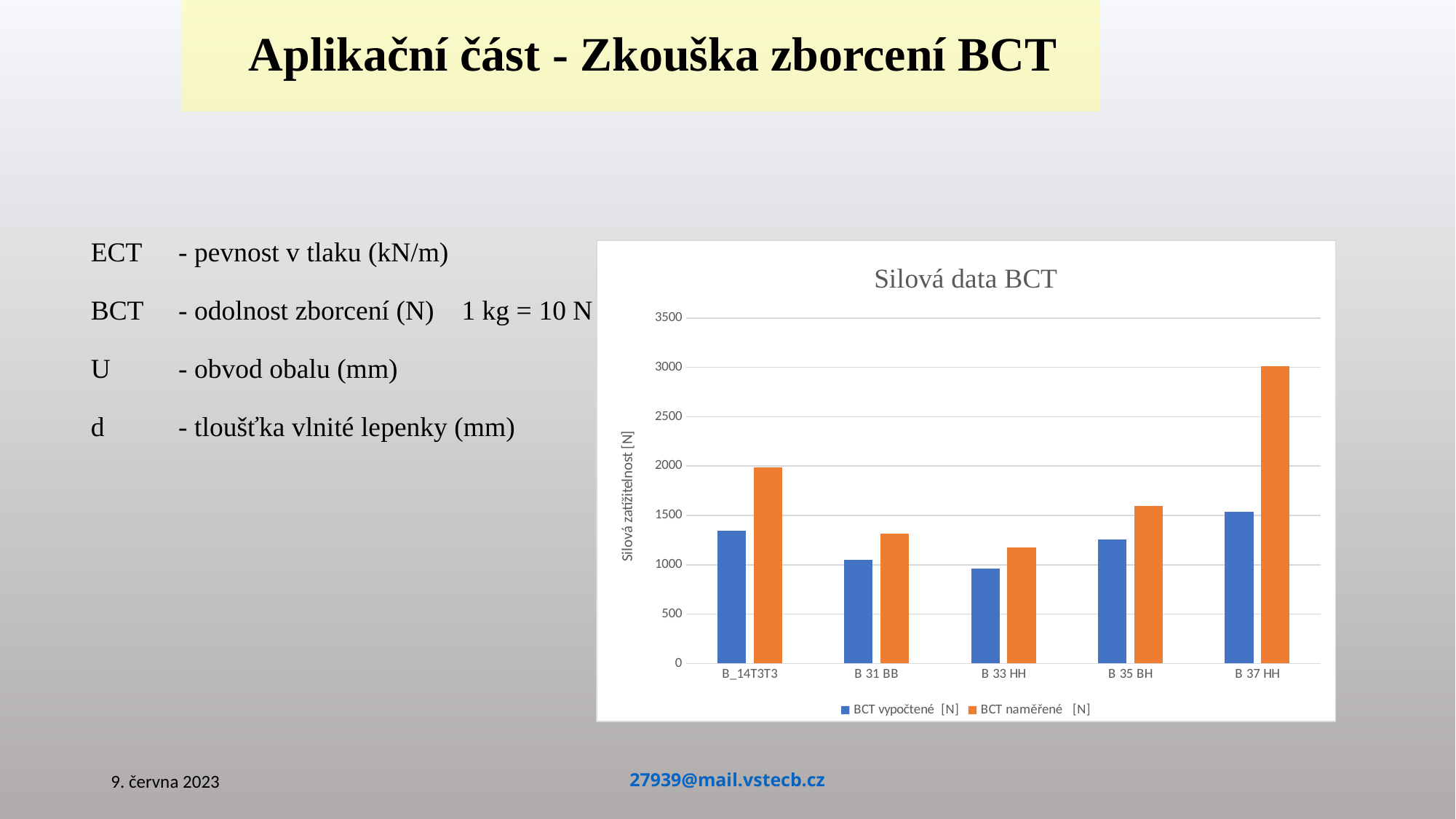
Which is larger, the BCT naměřené [N] value for B_14T3T3 or for B 35 BH? B_14T3T3 Which category has the lowest BCT vypočtené [N] value? B 33 HH Which category has the highest BCT naměřené [N] value? B 37 HH Is the BCT vypočtené [N] value for B_14T3T3 greater or less than 1000? greater Is the BCT naměřené [N] value for B 37 HH greater or less than 2500? greater What is the title of the chart? Silová data BCT How many series does the chart legend list? 2 For B 37 HH, which is larger, BCT vypočtené [N] or BCT naměřené [N]? BCT naměřené [N] What type of chart is shown on the slide? bar chart How many categories are shown on the x axis of the chart? 5 Is the BCT naměřené [N] value for B 35 BH greater or less than 1500? greater